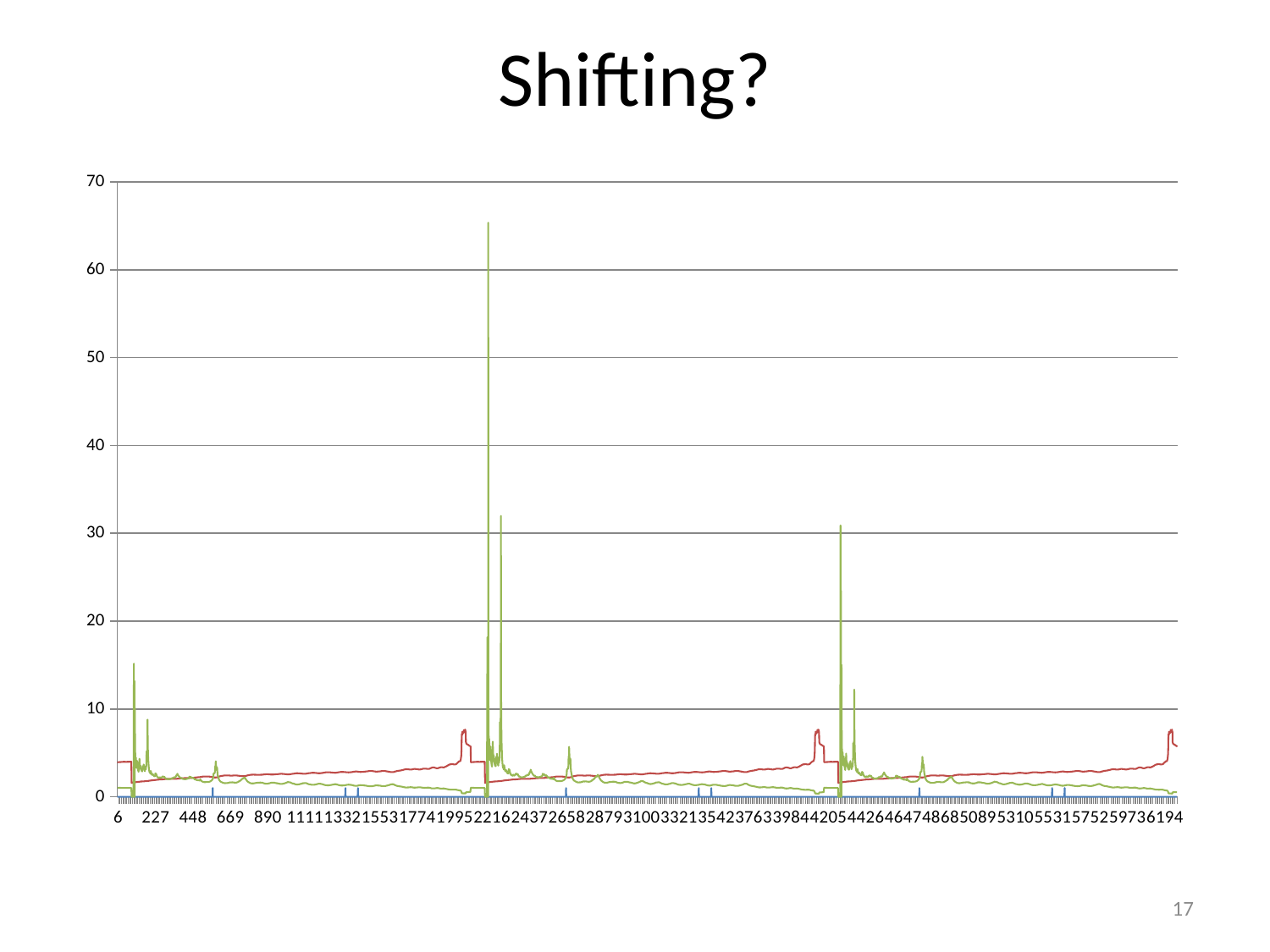
Is the highest point of the red line greater or less than 10? less Is the green spike near the x-axis label 2054 greater or less than 40? less Is the first green spike near the left edge of the chart greater or less than 20? less What is the title of the chart? Shifting? Which line reaches the highest value on the chart, the red line or the green line? green What is the first label shown on the horizontal axis? 6 What is the highest value shown on the vertical axis of the chart? 70 What kind of chart is shown on the slide? line chart